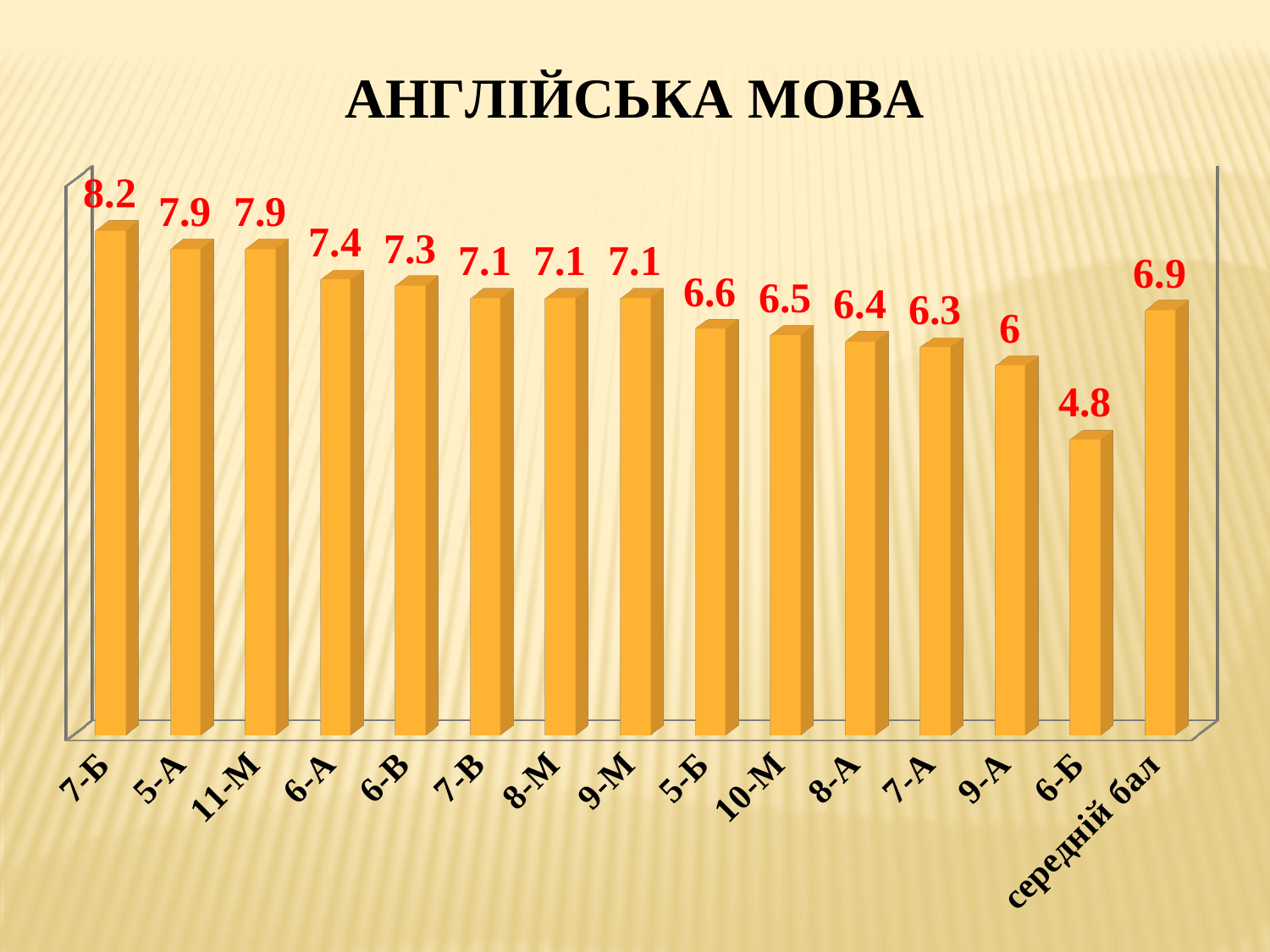
What is the value for 7-Б? 8.2 What is the value shown for середній бал? 6.9 What is the title of the slide? АНГЛІЙСЬКА МОВА What kind of chart is shown on the slide? bar chart Which category has the lowest value? 6-Б How many bars are shown in the chart? 15 Which category has the highest value? 7-Б What is the difference between the values for 6-А and 9-А? 1.4 What is the value for 6-Б? 4.8 Which is larger, the value for 5-Б or the value for 7-А? 5-Б What is the difference between the values for 7-Б and 6-Б? 3.4 What is the value for 10-М? 6.5